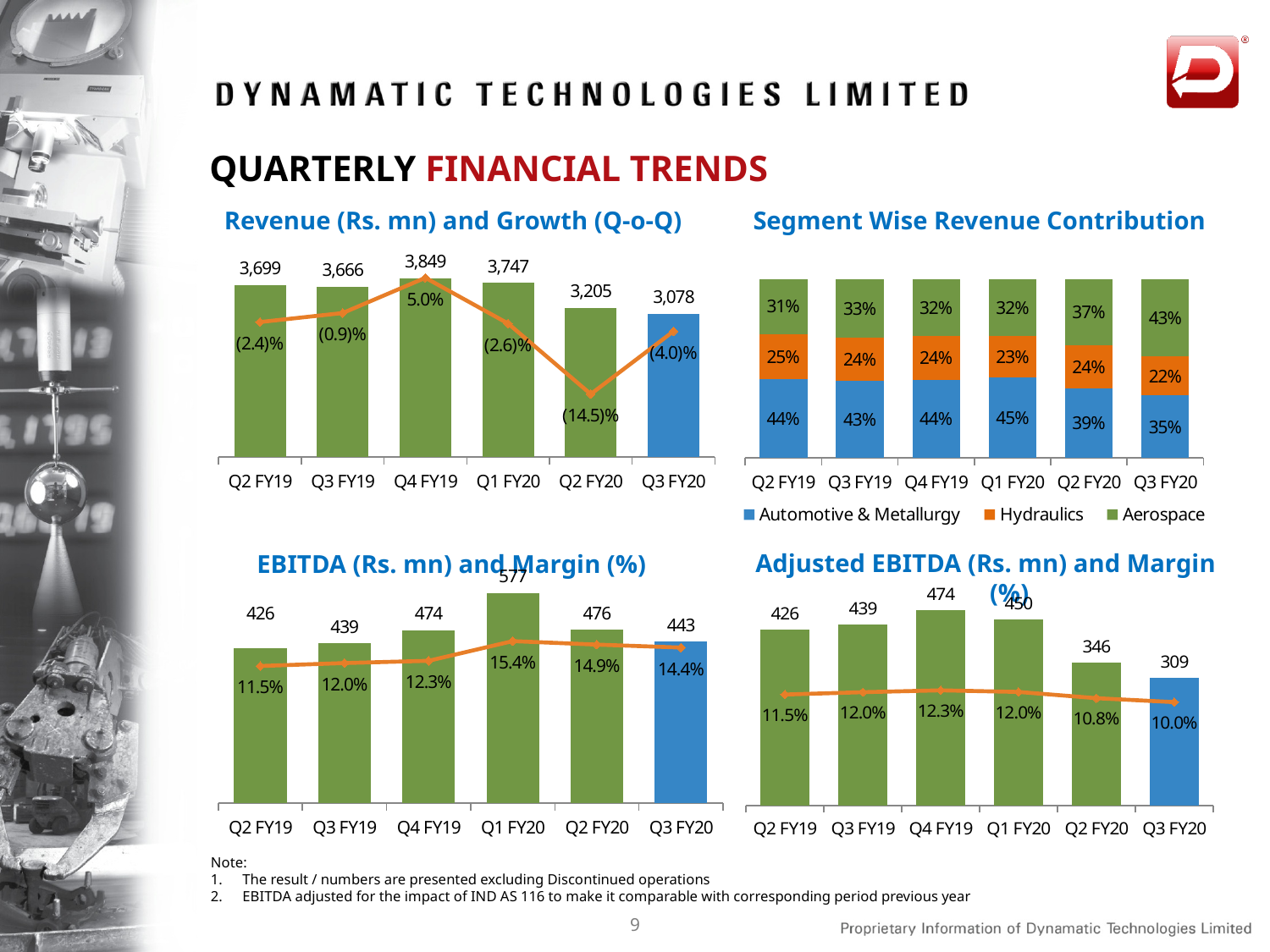
In the Revenue (Rs. mn) and Growth (Q-o-Q) chart, what is the Q-o-Q growth shown for Q2 FY20? (14.5)% In the Adjusted EBITDA (Rs. mn) and Margin (%) chart, is the adjusted EBITDA for Q1 FY20 or Q3 FY20 larger? Q1 FY20 In the Adjusted EBITDA (Rs. mn) and Margin (%) chart, what is the adjusted EBITDA for Q2 FY20? 346 In the EBITDA (Rs. mn) and Margin (%) chart, what is the margin for Q3 FY20? 14.4% In the Segment Wise Revenue Contribution chart, what is the Aerospace share in Q3 FY20? 43% In the Revenue (Rs. mn) and Growth (Q-o-Q) chart, what is the revenue for Q4 FY19? 3,849 In the EBITDA (Rs. mn) and Margin (%) chart, which quarter has the highest EBITDA? Q1 FY20 How many series does the legend of the Segment Wise Revenue Contribution chart list? 3 In the Revenue (Rs. mn) and Growth (Q-o-Q) chart, what is the difference in revenue between Q1 FY20 and Q2 FY20? 542 In the Revenue (Rs. mn) and Growth (Q-o-Q) chart, which quarter has the lowest revenue? Q3 FY20 How many quarters are shown on the x axis of the Adjusted EBITDA (Rs. mn) and Margin (%) chart? 6 In the Segment Wise Revenue Contribution chart, what is the Hydraulics share in Q1 FY20? 23%